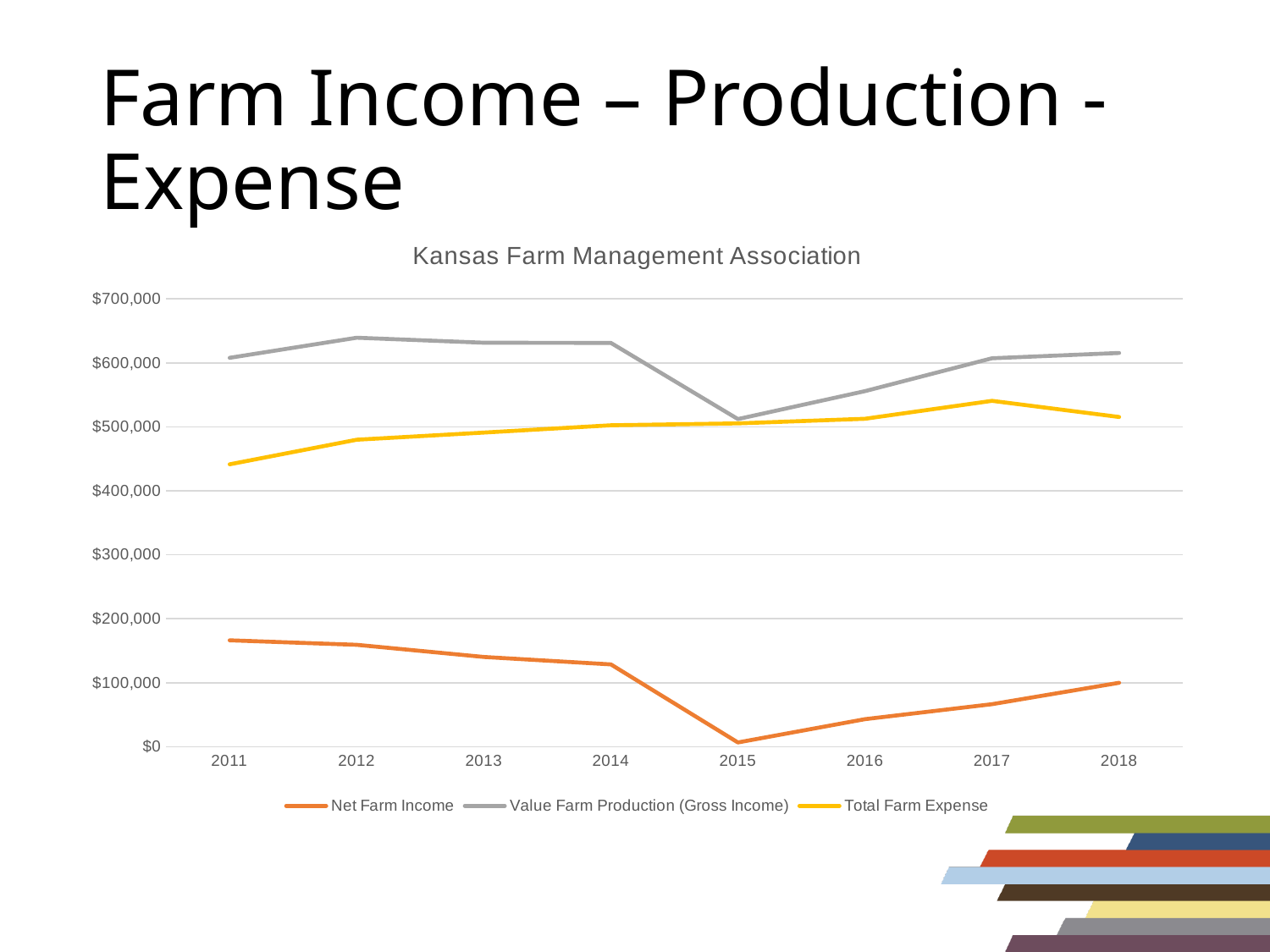
In 2014, which is larger: Value Farm Production (Gross Income) or Total Farm Expense? Value Farm Production (Gross Income) In which year is Total Farm Expense highest? 2017 How many series does the legend list? 3 In which year is Net Farm Income lowest? 2015 Is the value for Total Farm Expense in 2011 greater or less than $500,000? less In which year is Value Farm Production (Gross Income) lowest? 2015 What kind of chart is shown on the slide? Line chart Is the value for Net Farm Income in 2011 greater or less than $100,000? greater How many years are shown on the x axis? 8 What is the title of the chart? Kansas Farm Management Association Is the value for Value Farm Production (Gross Income) in 2015 greater or less than $600,000? less Does Net Farm Income rise or fall from 2011 to 2015? Fall